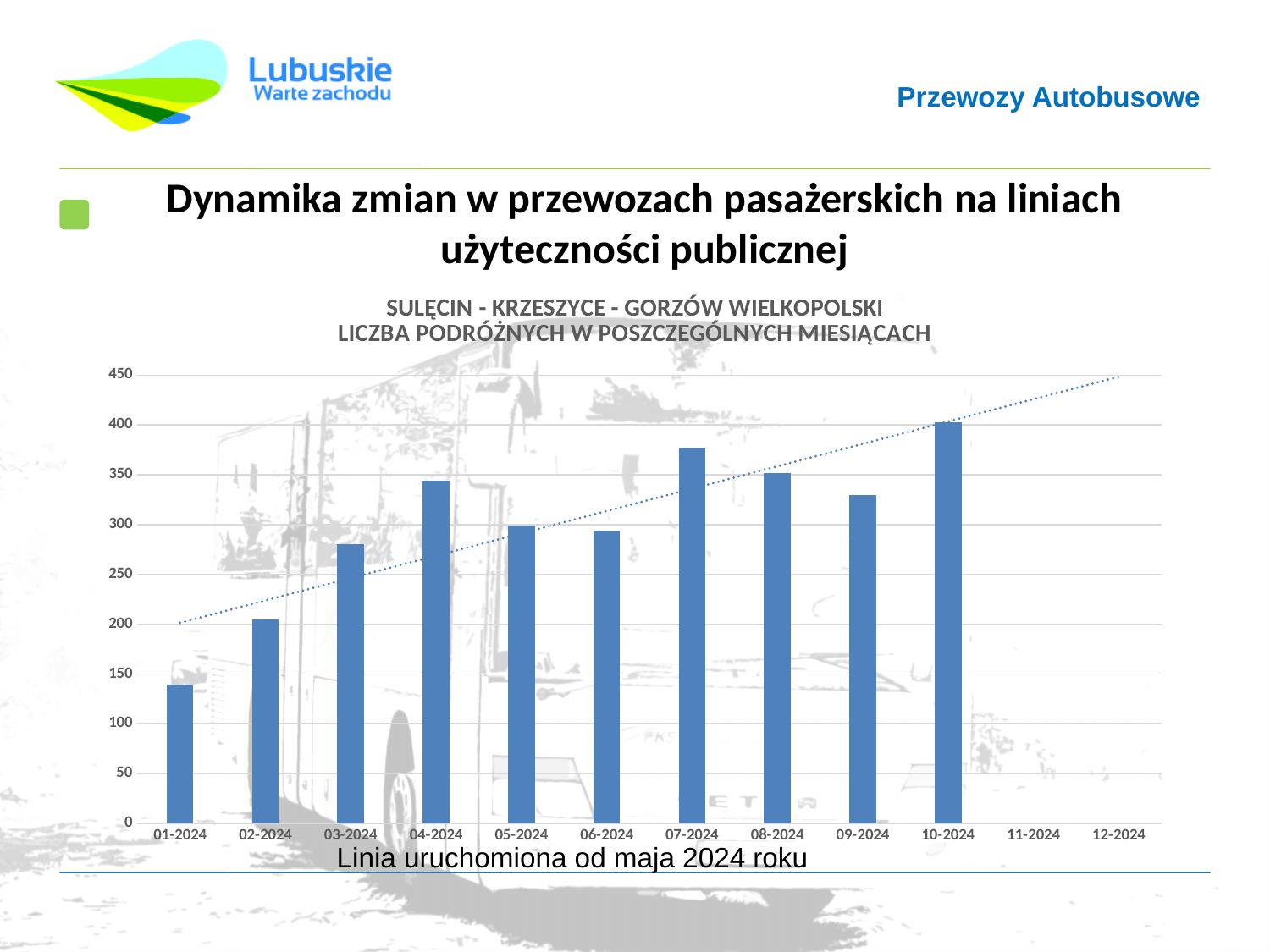
Is the value for 09-2024 greater or less than 300? greater How many months have a bar plotted on the chart? 10 Which month has more passengers, 04-2024 or 05-2024? 04-2024 Is the value for 03-2024 greater or less than 250? greater Which month has the highest number of passengers? 10-2024 Is the value for 10-2024 greater or less than 350? greater Which month has more passengers, 07-2024 or 08-2024? 07-2024 Which month has the lowest number of passengers? 01-2024 What kind of chart is shown on the slide? bar chart What is the overall trend of the dotted trend line from 01-2024 to 12-2024? rising